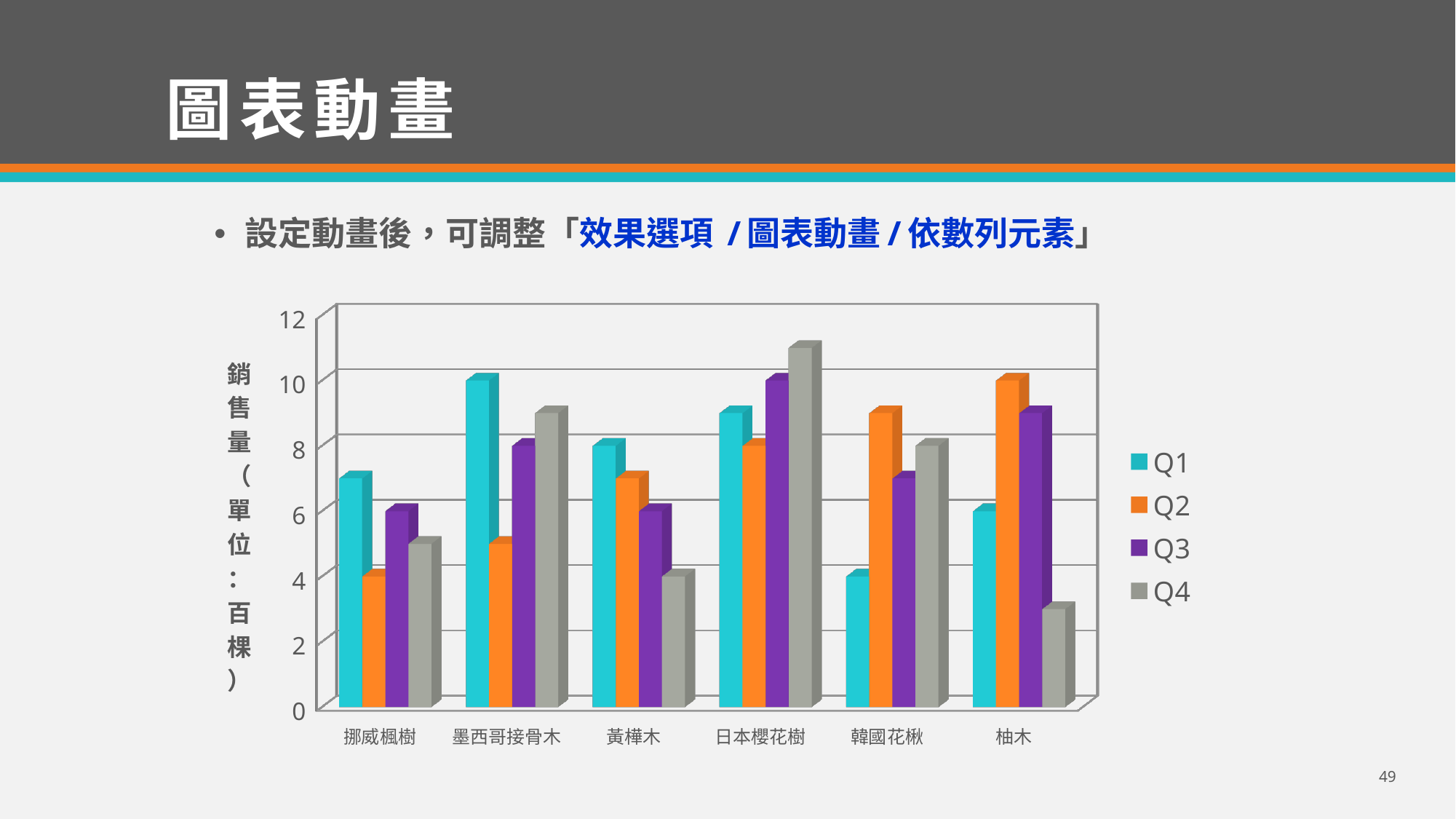
Which category has the highest Q4 value? 日本櫻花樹 Is the Q4 value for 日本櫻花樹 greater or less than 10? greater Is the Q1 value for 墨西哥接骨木 greater or less than 8? greater What kind of chart is shown on the slide? bar chart How many series does the chart's legend list? 4 Which category has the highest Q1 value? 墨西哥接骨木 Is the Q4 value for 柚木 greater or less than 4? less How many categories are shown on the x axis of the chart? 6 Which category has the lowest Q4 value? 柚木 For 柚木, which is larger, the Q1 value or the Q2 value? Q2 Which category has the lowest Q1 value? 韓國花楸 What is the label of the vertical axis of the chart? 銷售量（單位：百棵）